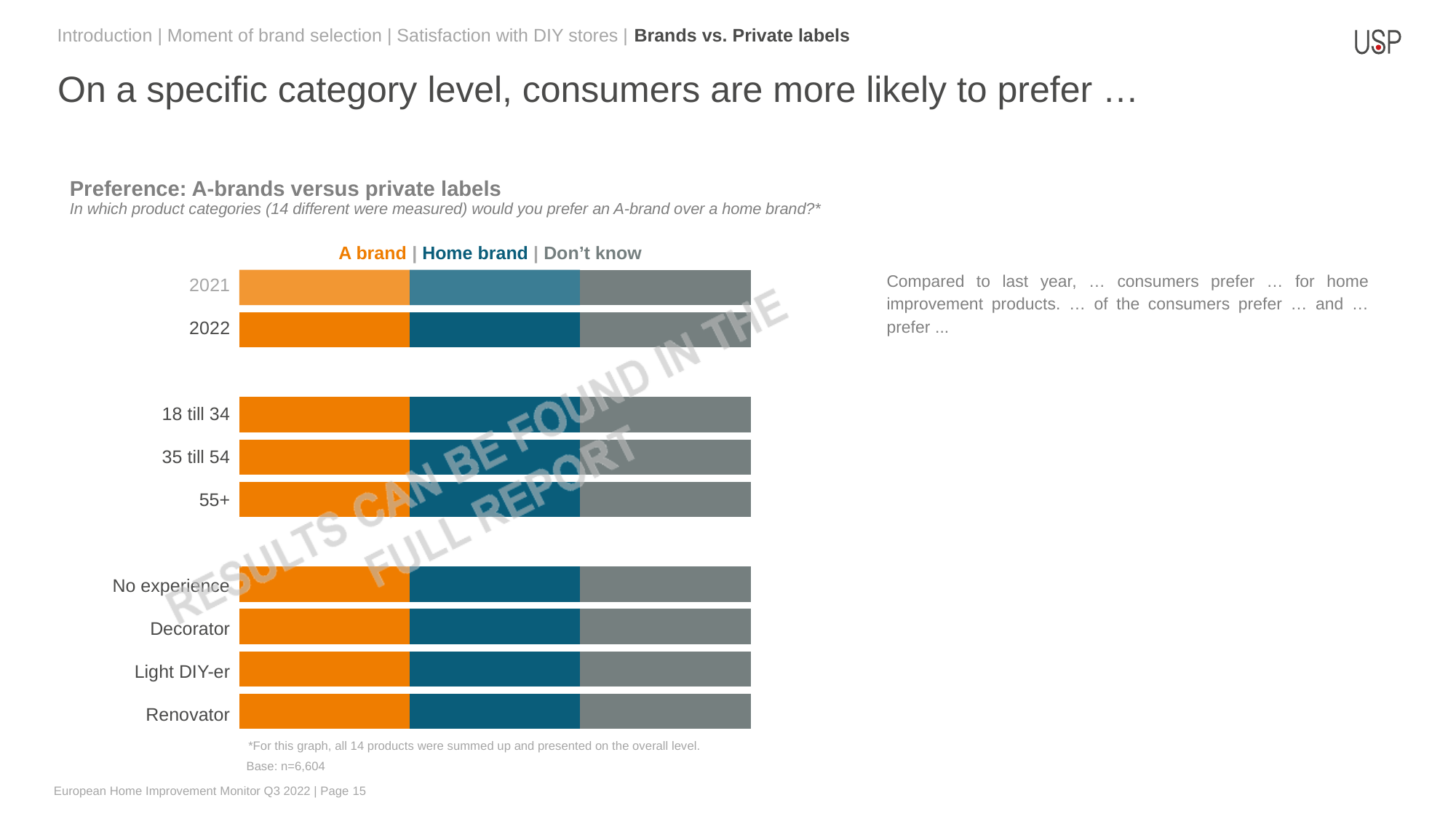
What is the base (sample size) stated below the chart? n=6,604 How many year categories are plotted in the chart? 2 Which series is shown in orange in the chart? A brand How many age-group categories are plotted in the chart? 3 What kind of chart is shown on the slide? stacked bar chart How many categories (bars) are plotted in the chart? 9 How many series does the legend of the chart list? 3 What is the title of the chart? Preference: A-brands versus private labels